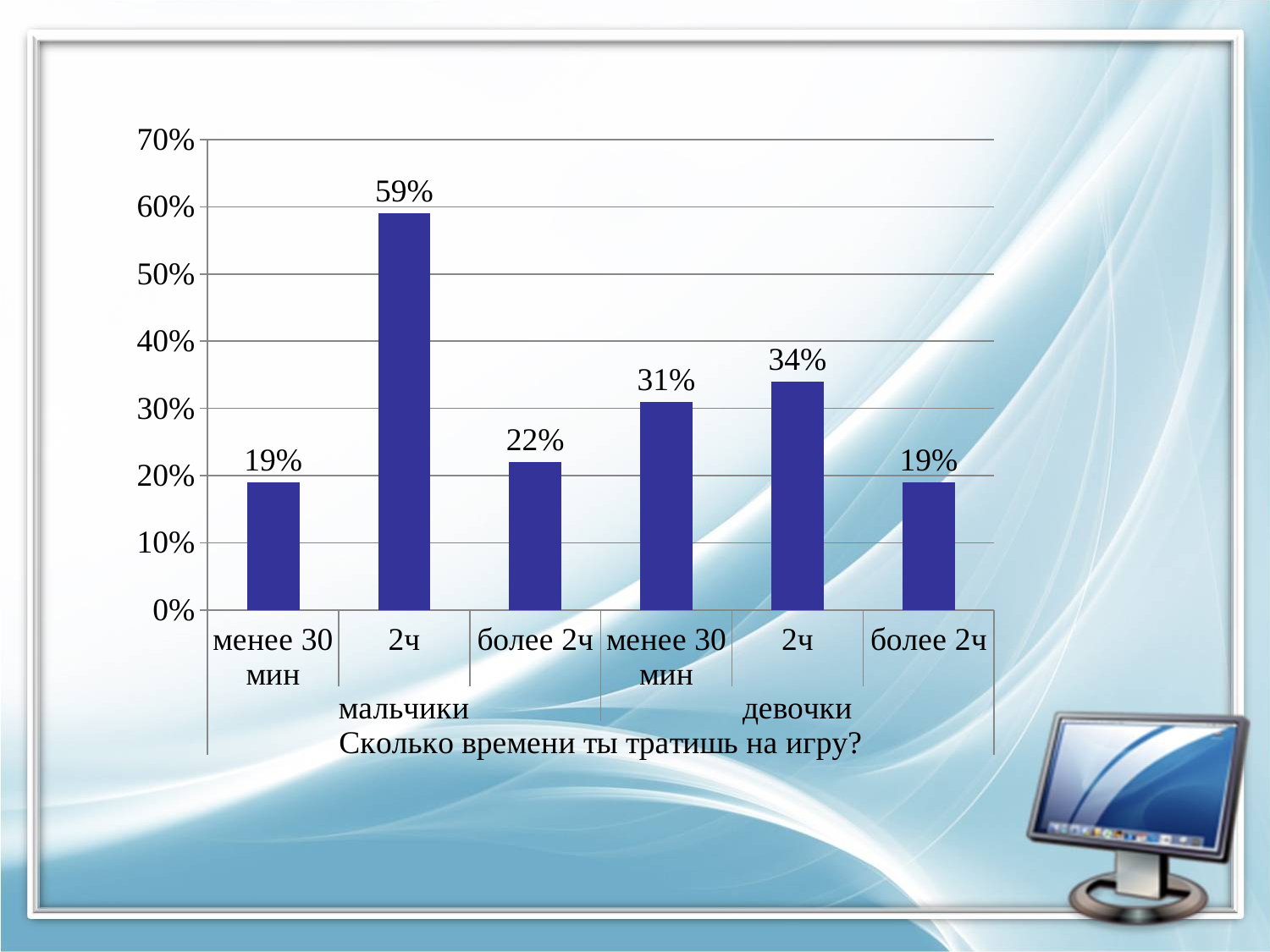
What question is written as the horizontal axis title of the chart? Сколько времени ты тратишь на игру? Among the girls (девочки), which time category has the highest value? 2ч What type of chart is shown on the slide? bar chart Which bar has the highest value on the chart? мальчики, 2ч Which is larger: the boys' value for более 2ч or the girls' value for более 2ч? boys (мальчики) What is the difference between the boys' and girls' values for 2ч? 25% What percentage of girls (девочки) spend более 2ч on the game? 19% What percentage of boys (мальчики) spend 2ч on the game? 59% What percentage of girls (девочки) spend менее 30 мин on the game? 31% How many bars are plotted on the chart? 6 Among the boys (мальчики), which time category has the lowest value? менее 30 мин What is the difference between the girls' and boys' values for менее 30 мин? 12%